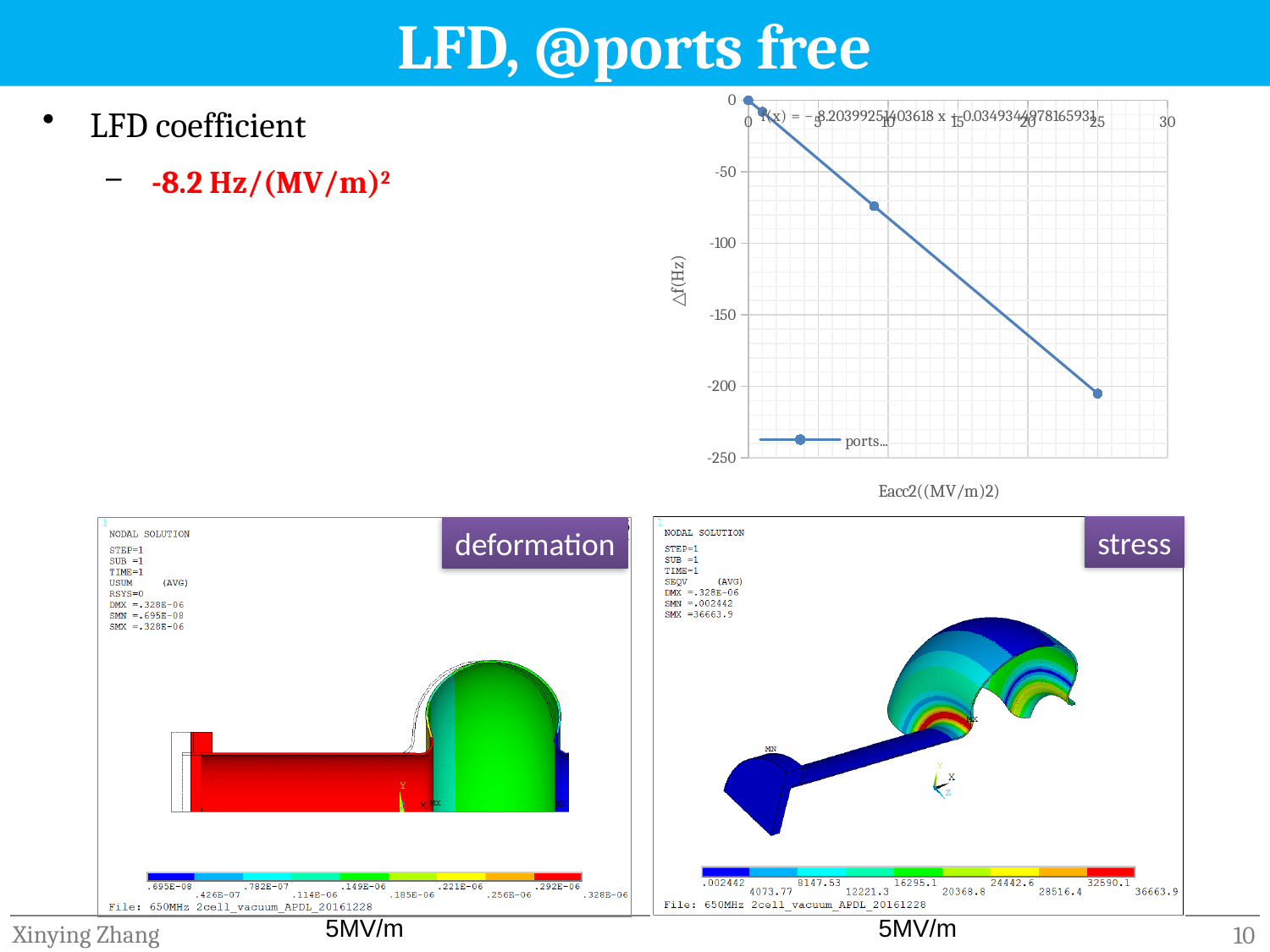
What is the label of the y axis of the upper-right chart? △f(Hz) What kind of chart is shown in the upper right of the slide? line chart How many data points are plotted in the upper-right chart? 4 What is the label of the x axis of the upper-right chart? Eacc2((MV/m)2) In the upper-right chart, at which x value does the lowest △f value occur? 25 In the upper-right chart, do the values rise or fall as Eacc2 increases along the x axis? fall How many series does the legend of the upper-right chart list? 1 What LFD coefficient is stated on the slide? -8.2 Hz/(MV/m)² In the upper-right chart, is the △f value at the point near x = 10 greater or less than -50? less In the upper-right chart, at which x value does the highest △f value occur? 0 In the upper-right chart, is the △f value at the point near x = 10 greater or less than -100? greater In the upper-right chart, is the △f value at the largest Eacc2 point (x = 25) greater or less than -150? less